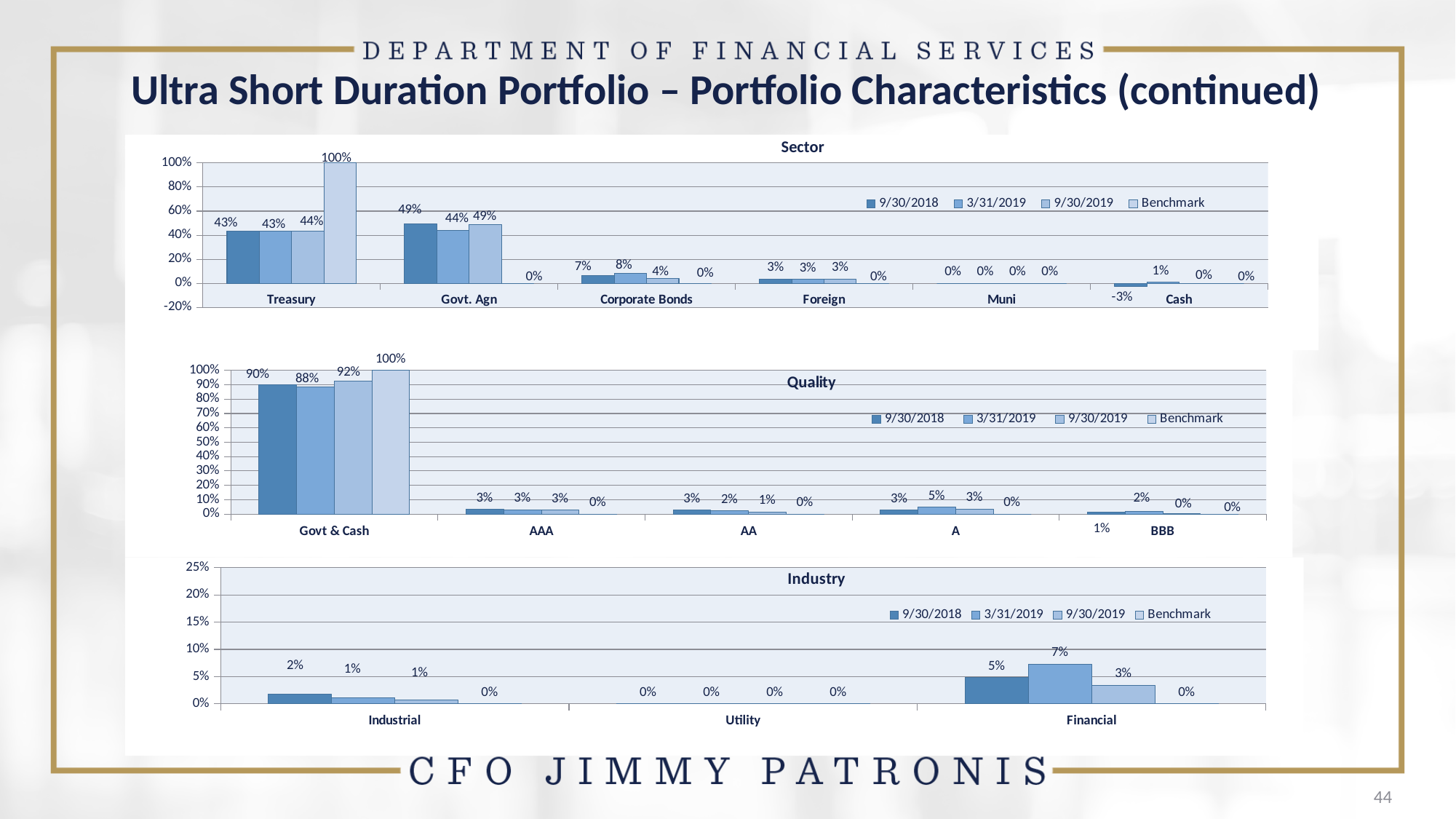
In the Industry chart, what is the 3/31/2019 value for Financial? 7% In the Industry chart, which is larger: the 9/30/2018 value for Industrial or the 9/30/2018 value for Financial? Financial In the Sector chart, what is the 9/30/2018 value for Cash? -3% In the Sector chart, what is the Benchmark value for Treasury? 100% In the Quality chart, how many series does the legend list? 4 In the Sector chart, how many sector categories are shown on the x axis? 6 In the Industry chart, what is the difference between the 3/31/2019 and 9/30/2019 values for Financial? 4% In the Sector chart, what is the difference between the 9/30/2018 and 9/30/2019 values for Corporate Bonds? 3% In the Quality chart, what is the 3/31/2019 value for A? 5% What type of chart is the Industry chart? Bar chart In the Quality chart, which category has the highest 9/30/2019 value? Govt & Cash In the Quality chart, what is the 3/31/2019 value for Govt & Cash? 88%